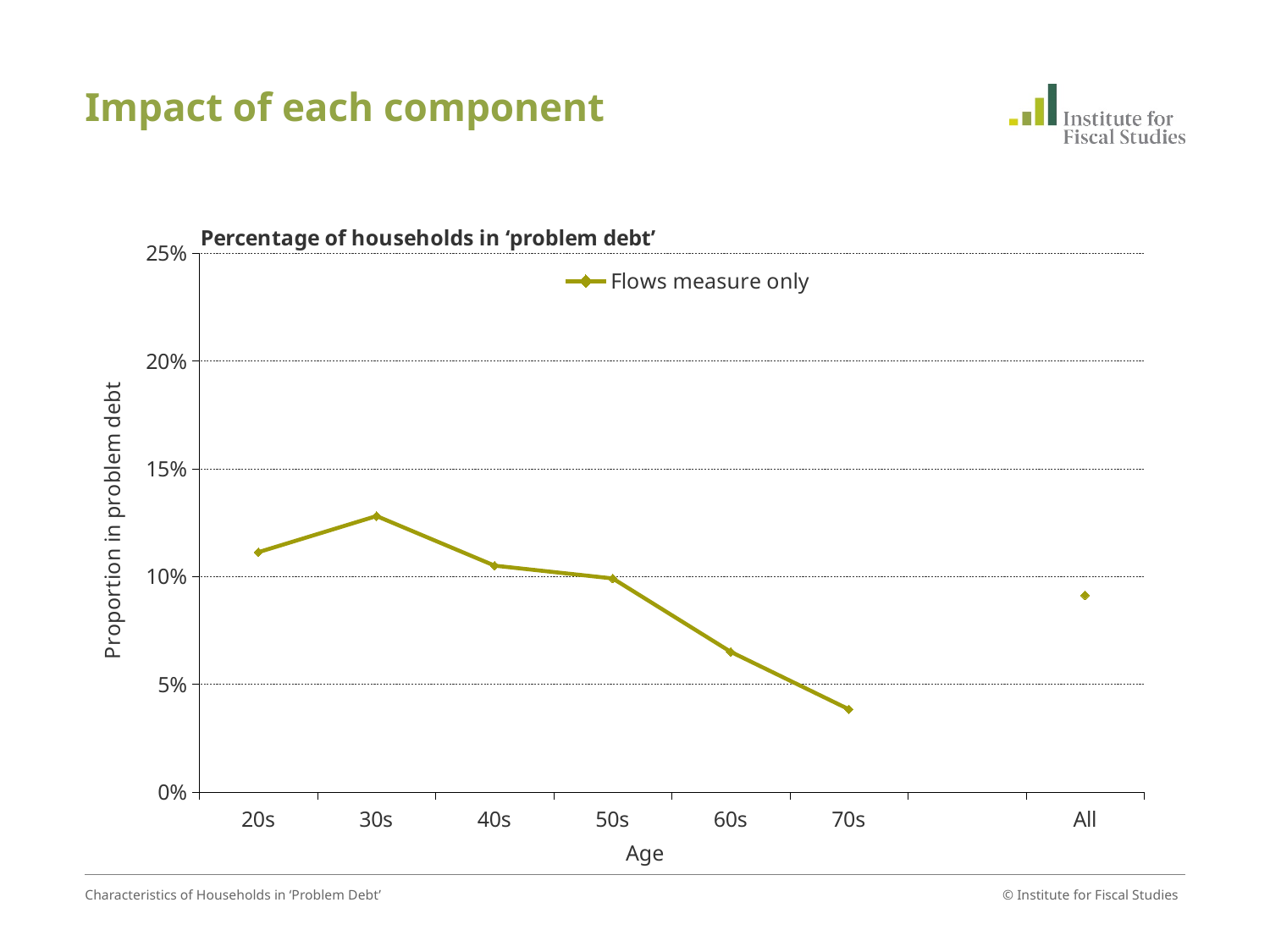
Which age group has the lowest proportion in problem debt? 70s Is the value for 'All' greater or less than 10%? less Which age group has the highest proportion in problem debt? 30s Is the value for the 60s age group greater or less than 10%? less Is the value for the 70s age group greater or less than 5%? less What kind of chart is shown on the slide? line chart From the 30s age group to the 70s age group, do the values rise or fall? fall How many series does the legend list? 1 Which has a higher proportion in problem debt, the 20s or the 60s age group? 20s How many age categories are plotted along the x axis, including 'All'? 7 What is the name of the series shown in the legend? Flows measure only